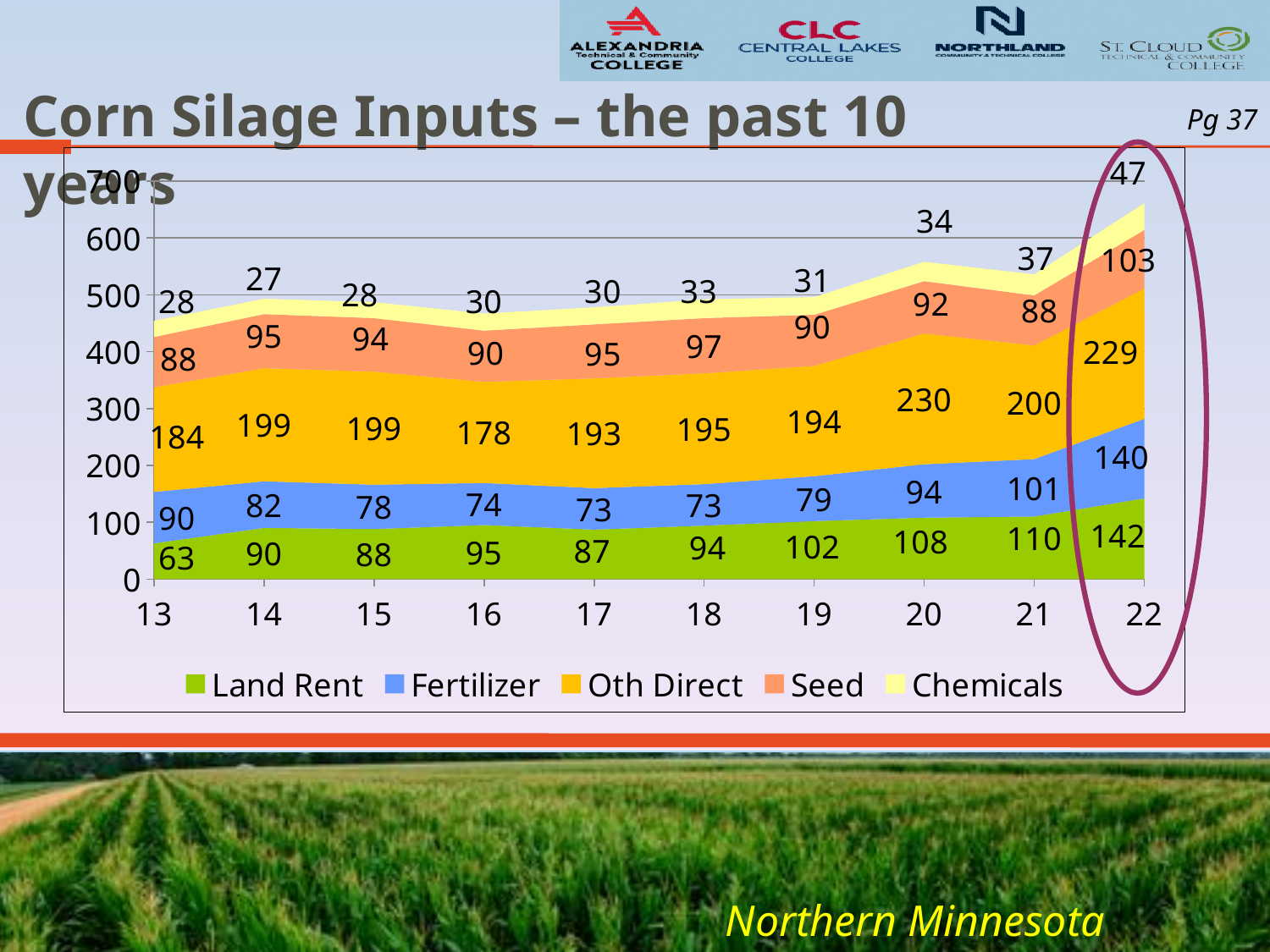
What is the Land Rent value for year 22? 142 Which series is shown in yellow in the legend? Chemicals In which year is the Chemicals value highest? 22 What is the total of all five inputs for year 22? 661 How many series does the legend list? 5 In which year is the Land Rent value lowest? 13 What is the difference between the Fertilizer value in year 22 and in year 21? 39 How many years are shown along the x axis? 10 What is the Seed value for year 18? 97 What kind of chart is shown on the slide? stacked area chart What is the Oth Direct value for year 20? 230 Which is larger, the Oth Direct value in year 16 or in year 17? year 17